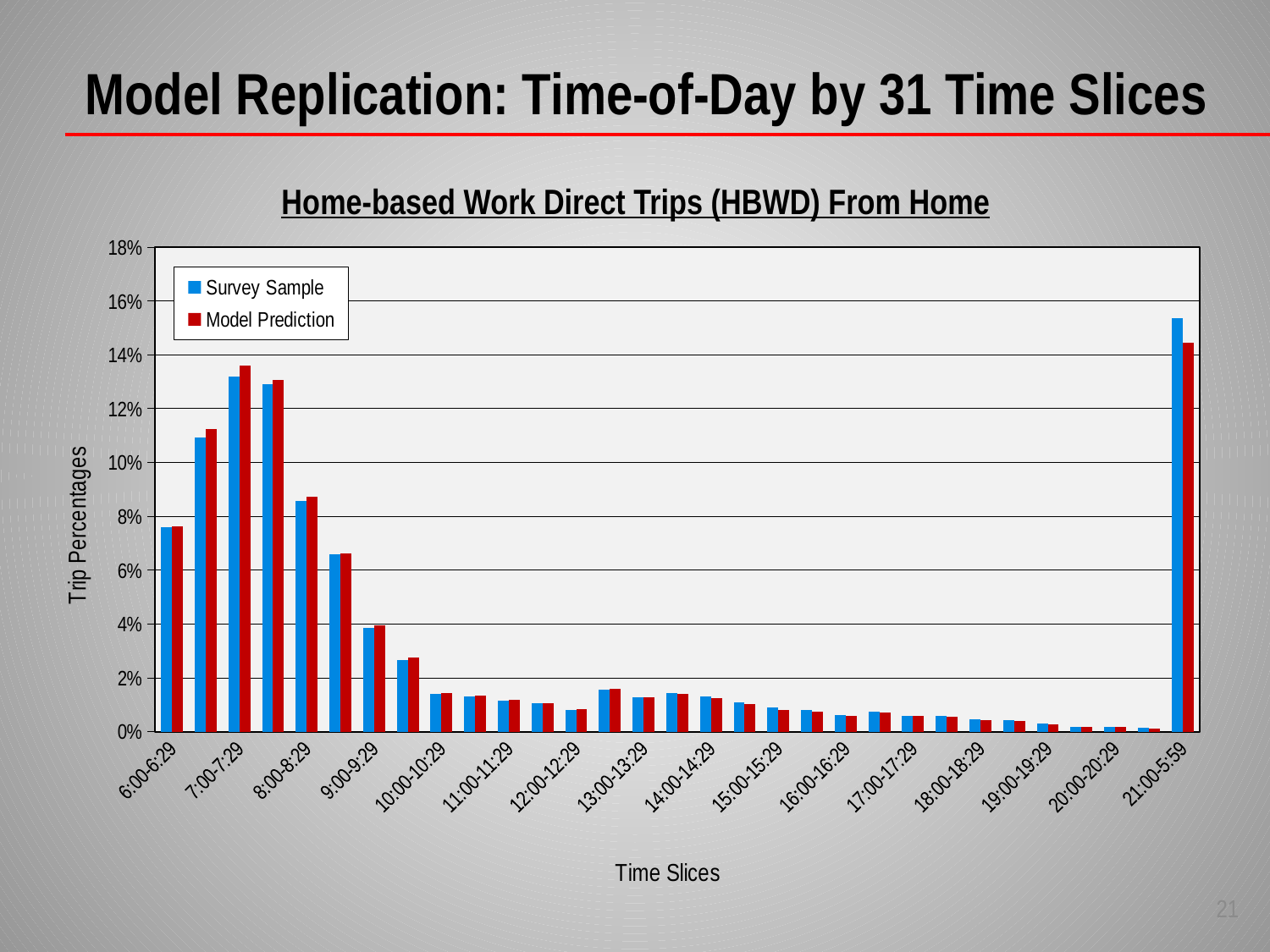
Is the Survey Sample value for 21:00-5:59 greater or less than 14%? greater What kind of chart is shown on the slide? Bar chart What is the title of the chart? Home-based Work Direct Trips (HBWD) From Home For the 21:00-5:59 time slice, which is larger: Survey Sample or Model Prediction? Survey Sample Is the Model Prediction value for 10:00-10:29 greater or less than 2%? less What are the two series named in the legend? Survey Sample and Model Prediction How many time slices does the chart cover? 31 Is the Survey Sample value for 6:00-6:29 greater or less than 6%? greater Which time slice has the highest Model Prediction value? 21:00-5:59 How many series does the legend list? 2 Which time slice has the highest Survey Sample value? 21:00-5:59